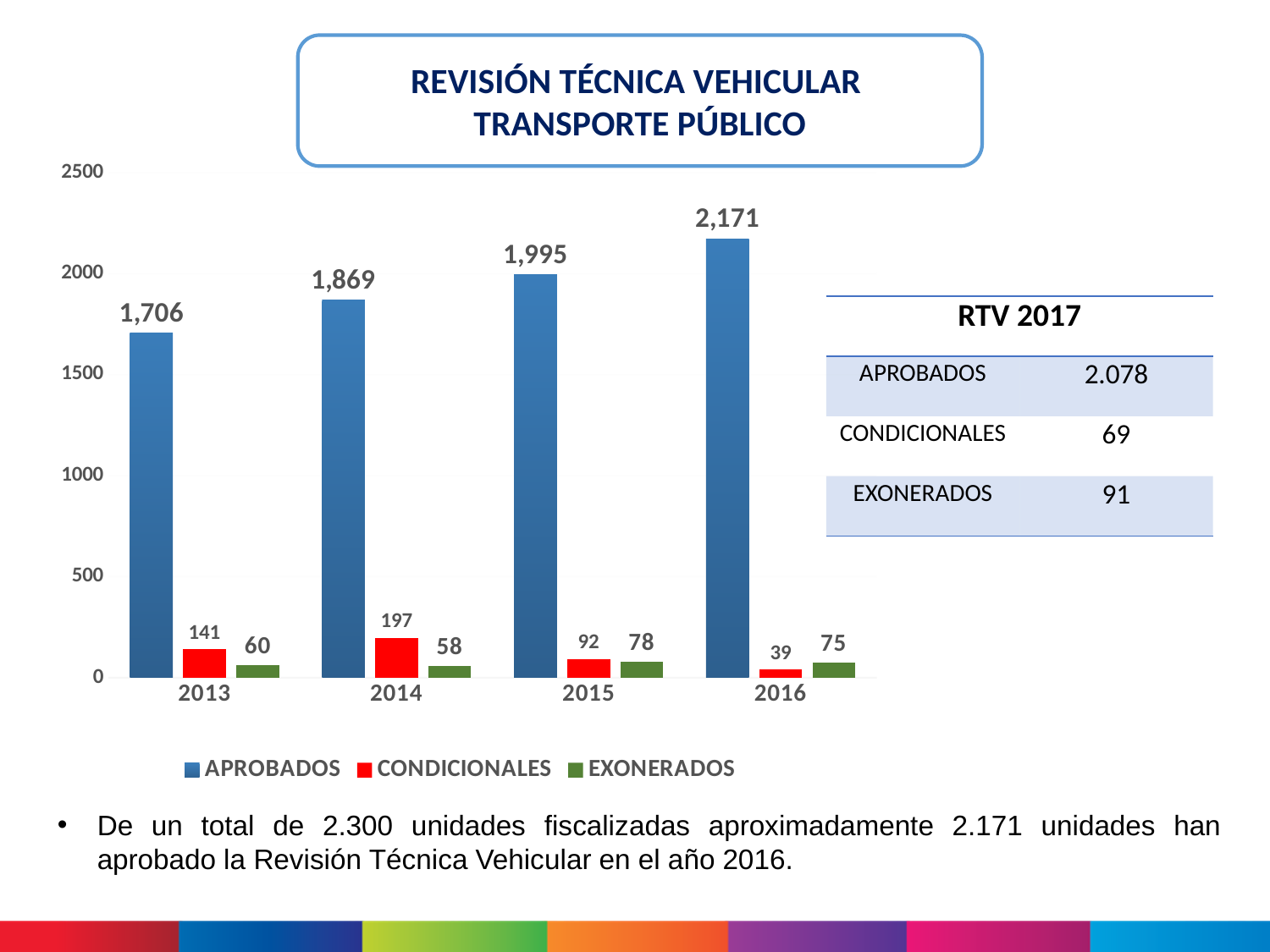
Which is larger, CONDICIONALES in 2013 or EXONERADOS in 2013? CONDICIONALES in 2013 In which year is the APROBADOS value lowest? 2013 How many years are shown on the x axis of the chart? 4 What is the value for APROBADOS in 2016? 2,171 What is the value for EXONERADOS in 2015? 78 Is the APROBADOS value for 2014 greater or less than 2000? less In which year is the CONDICIONALES value highest? 2014 What kind of chart is shown on the slide? bar chart How many series does the chart legend list? 3 What is the value for CONDICIONALES in 2014? 197 Do the APROBADOS values rise or fall from 2013 to 2016? rise What is the difference between the APROBADOS values for 2016 and 2015? 176